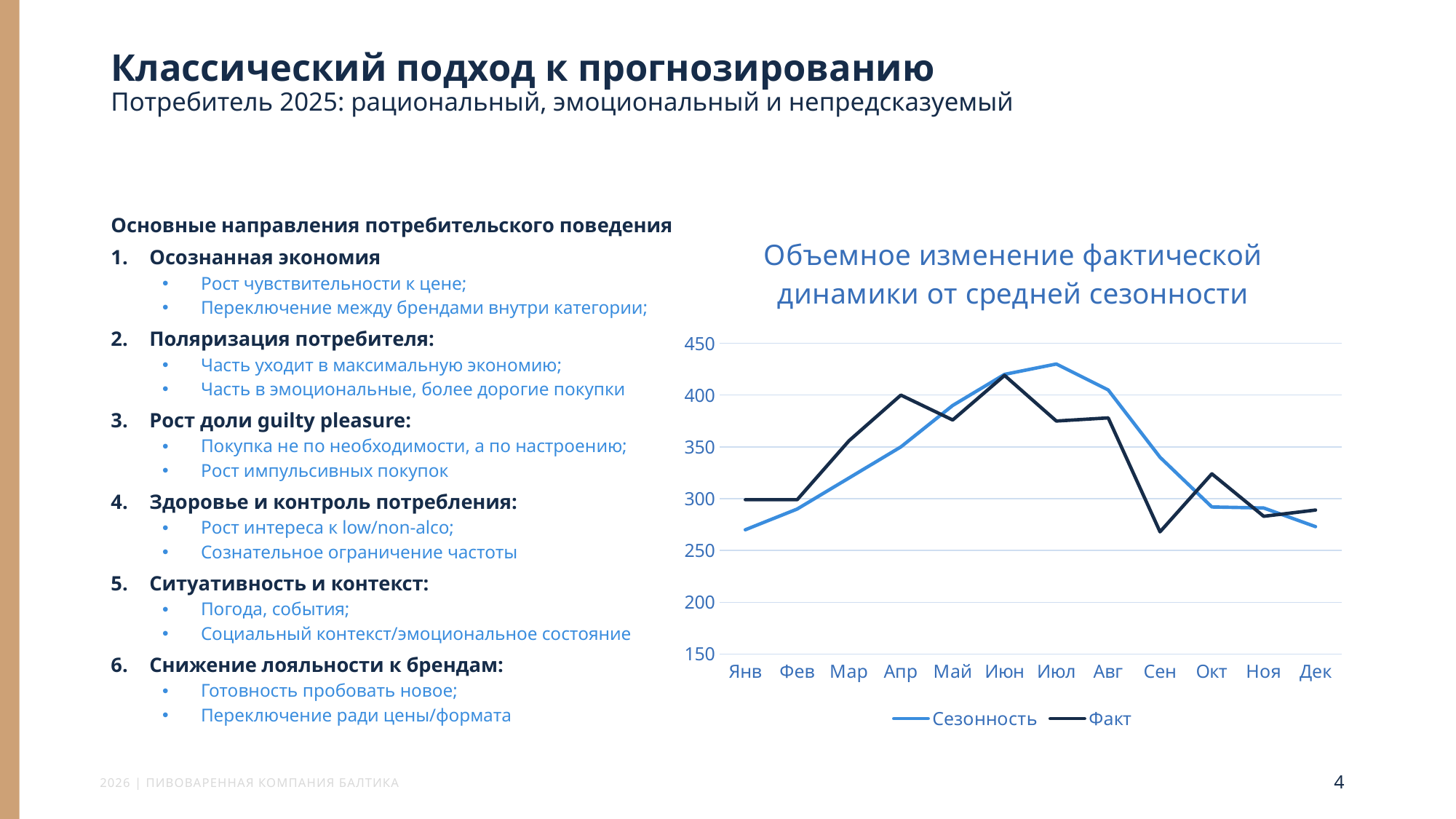
How many series does the legend of the chart list? 2 Which series in the chart is drawn in blue? Сезонность Does the Сезонность series rise or fall from Янв to Июл? rise Is the value of Сезонность in Июл greater or less than 400? greater In Апр, which series has the larger value, Сезонность or Факт? Факт In which month does the Факт series reach its lowest value? Сен What is the title of the chart? Объемное изменение фактической динамики от средней сезонности In which month does the Факт series reach its highest value? Июн In which month does the Сезонность series reach its highest value? Июл What kind of chart is shown on the slide? line chart Is the value of Факт in Сен greater or less than 300? less How many months are plotted along the x axis of the chart? 12